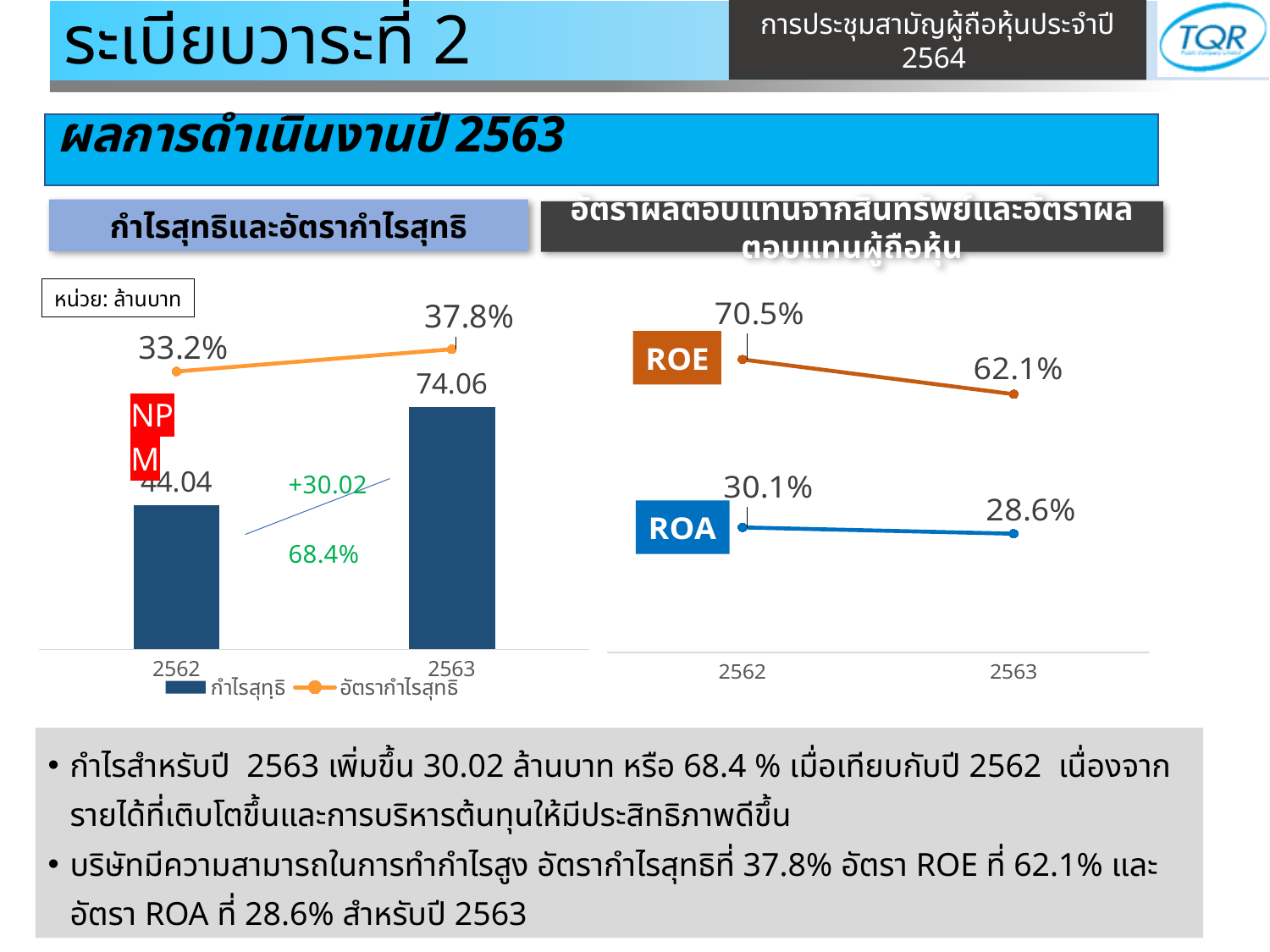
In the left chart, what is the difference in net profit between 2563 and 2562? 30.02 In the right chart, what is the ROE for 2562? 70.5% In the left chart (กำไรสุทธิและอัตรากำไรสุทธิ), what is the net profit (กำไรสุทธิ) for 2562? 44.04 In the left chart, which year has the higher net profit, 2562 or 2563? 2563 In the right chart, what is the difference between ROE and ROA in 2563? 33.5% How many series does the legend of the left chart list? 2 In the left chart (กำไรสุทธิและอัตรากำไรสุทธิ), what is the net profit (กำไรสุทธิ) for 2563? 74.06 What unit is shown for the left chart? ล้านบาท In the left chart, what is the net profit margin (อัตรากำไรสุทธิ) for 2563? 37.8% In the right chart, does the ROE line rise or fall from 2562 to 2563? fall In the right chart, what is the ROA for 2563? 28.6% In the left chart, does the net profit margin line rise or fall from 2562 to 2563? rise